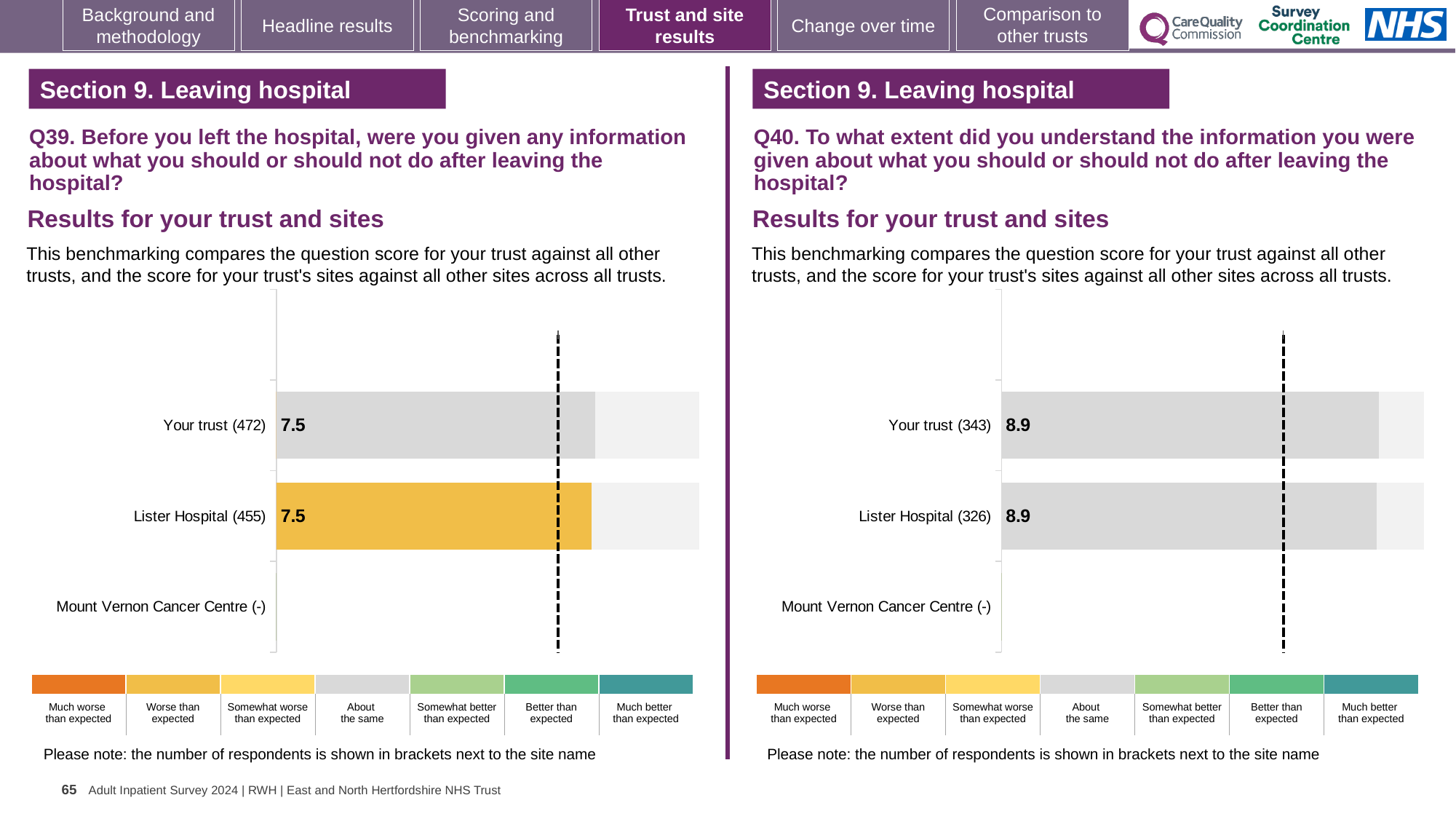
In the Q40 chart on the right, what is the score for Your trust? 8.9 In the Q39 chart on the left, what is the score for Lister Hospital? 7.5 In the Q40 chart on the right, what is the score for Lister Hospital? 8.9 In the Q39 chart on the left, which category has no score shown (marked with a dash)? Mount Vernon Cancer Centre In the Q40 chart on the right, what is the difference between the scores for Your trust and Lister Hospital? 0.0 In the Q40 chart on the right, how many respondents are shown in brackets for Your trust? 343 In the Q39 chart on the left, what is the score for Your trust? 7.5 How many categories (rows) are listed on the y axis of the Q39 chart on the left? 3 In the Q39 chart on the left, what is the difference between the scores for Your trust and Lister Hospital? 0.0 In the Q39 chart on the left, how many respondents are shown in brackets for Lister Hospital? 455 What kind of chart is the Q39 chart on the left? Bar chart How many categories (rows) are listed on the y axis of the Q40 chart on the right? 3